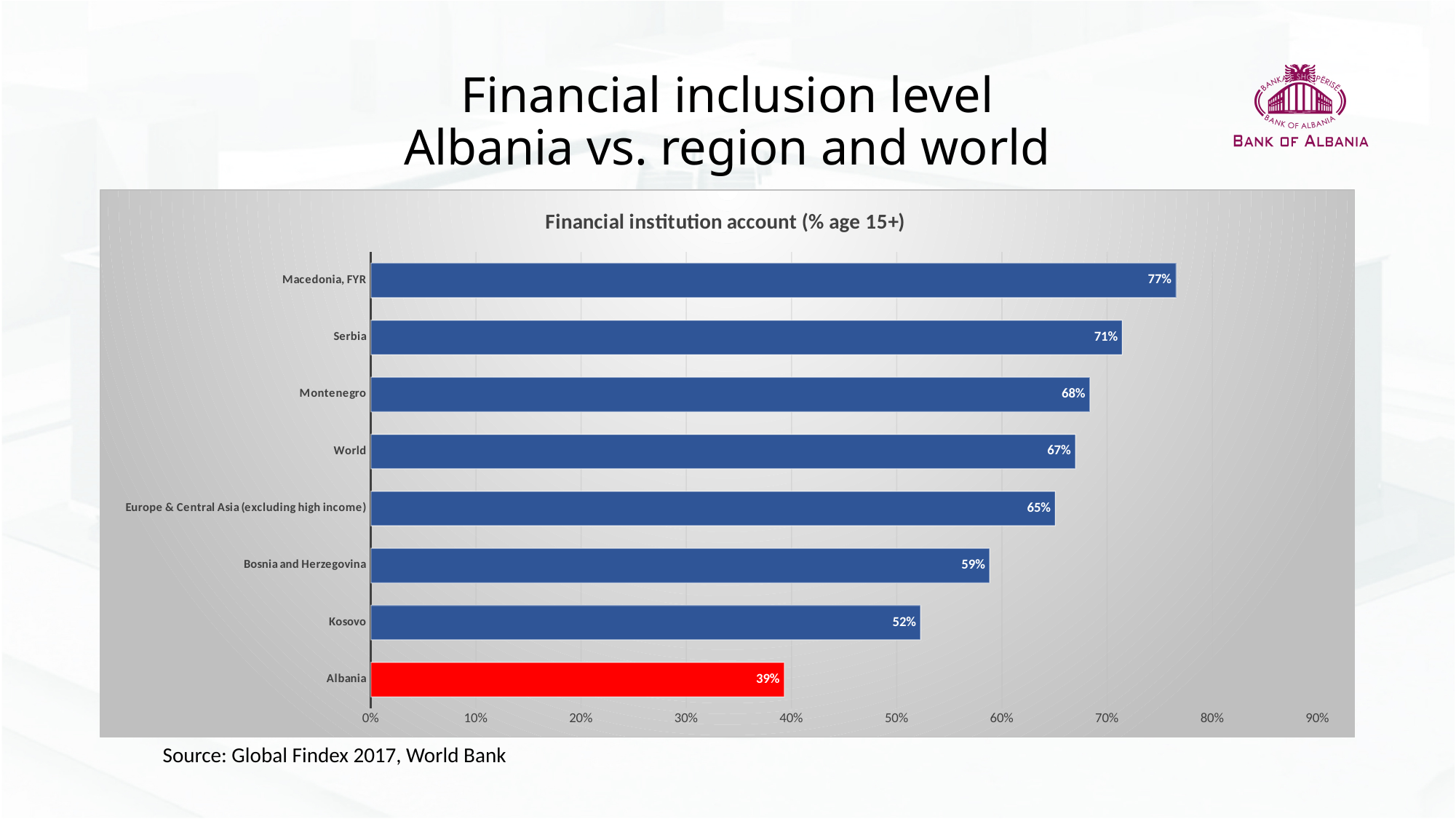
How many categories are shown in the chart? 8 Is the value for Montenegro greater or less than 60%? greater Which category has the lowest value? Albania What is the value for Albania? 39% What is the difference between the values for Macedonia, FYR and Albania? 38% What is the difference between the values for World and Kosovo? 15% Which is larger, the value for Bosnia and Herzegovina or the value for Kosovo? Bosnia and Herzegovina What is the value for Europe & Central Asia (excluding high income)? 65% What is the value for Serbia? 71% Which category has the highest value? Macedonia, FYR What kind of chart is shown on the slide? bar chart What is the title of the chart? Financial institution account (% age 15+)